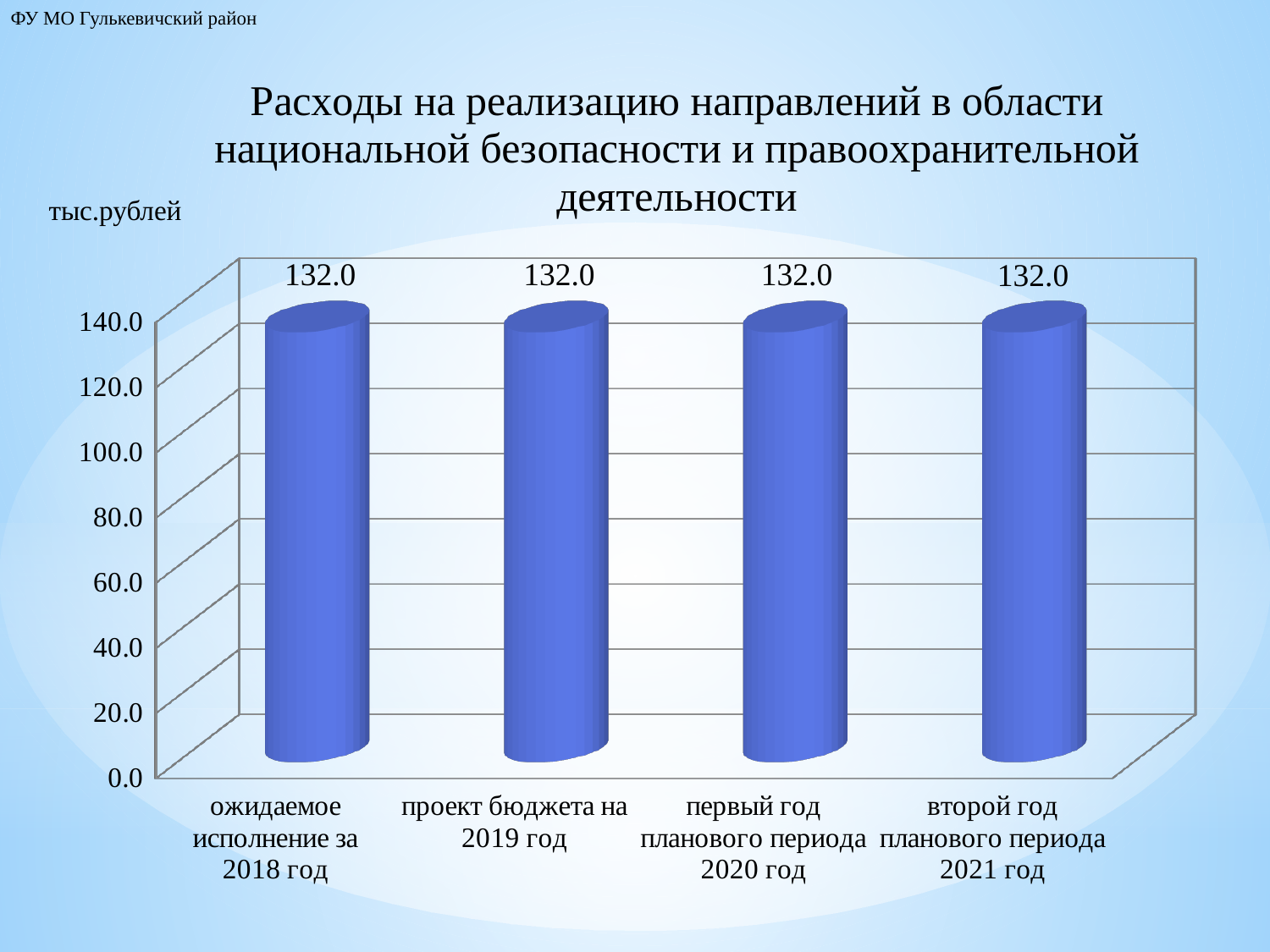
What is the title of the chart? Расходы на реализацию направлений в области национальной безопасности и правоохранительной деятельности What is the value for "проект бюджета на 2019 год"? 132.0 Is the value for "первый год планового периода 2020 год" greater or less than 140? less Do the values rise, fall or stay the same from 2018 to 2021? stay the same How many categories are shown on the x axis of the chart? 4 Is the value for "проект бюджета на 2019 год" larger than, smaller than or equal to the value for "второй год планового периода 2021 год"? equal What is the difference between the value for 2019 and the value for 2018? 0.0 What is the value for "первый год планового периода 2020 год"? 132.0 What kind of chart is shown on the slide? bar chart In what units are the values on the chart expressed, according to the label above the axis? тыс.рублей What is the value for "второй год планового периода 2021 год"? 132.0 What is the value for "ожидаемое исполнение за 2018 год"? 132.0